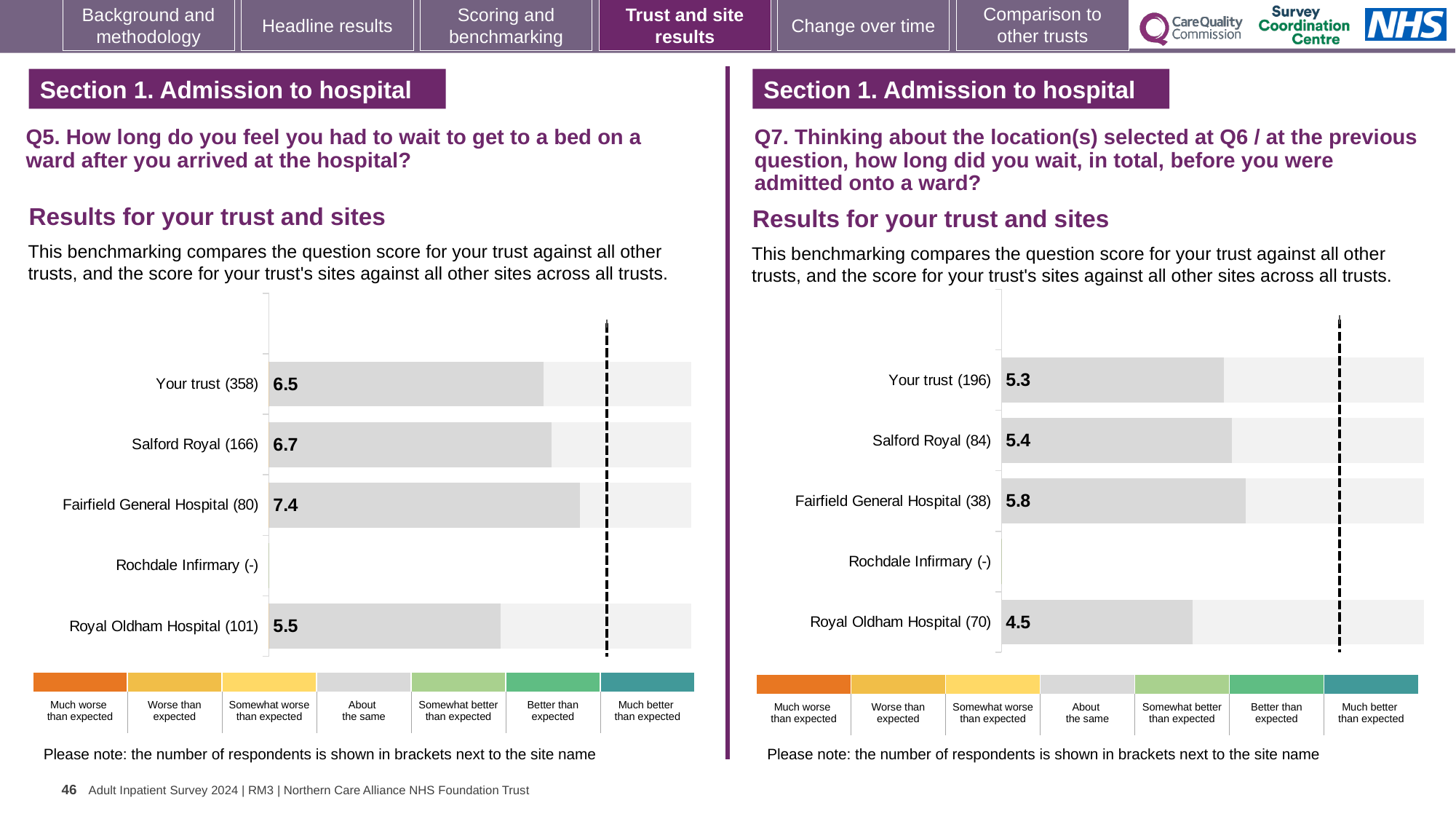
On the Q5 chart (left), what is the score for Fairfield General Hospital? 7.4 On the Q7 chart (right), what is the difference between the scores for Fairfield General Hospital and Your trust? 0.5 On the Q7 chart (right), which site has the lowest score? Royal Oldham Hospital On the Q5 chart (left), which site has the highest score? Fairfield General Hospital On the Q7 chart (right), how many respondents are shown in brackets for Your trust? 196 What kind of chart is used on the Q5 chart (left)? Bar chart On the Q5 chart (left), what is the score for Your trust? 6.5 On the Q7 chart (right), what is the score for Salford Royal? 5.4 How many sites or rows are listed on the Q7 chart (right)? 5 On the Q7 chart (right), what is the score for Royal Oldham Hospital? 4.5 On the Q5 chart (left), what is the difference between the scores for Fairfield General Hospital and Royal Oldham Hospital? 1.9 On the Q5 chart (left), which has the higher score, Salford Royal or Royal Oldham Hospital? Salford Royal